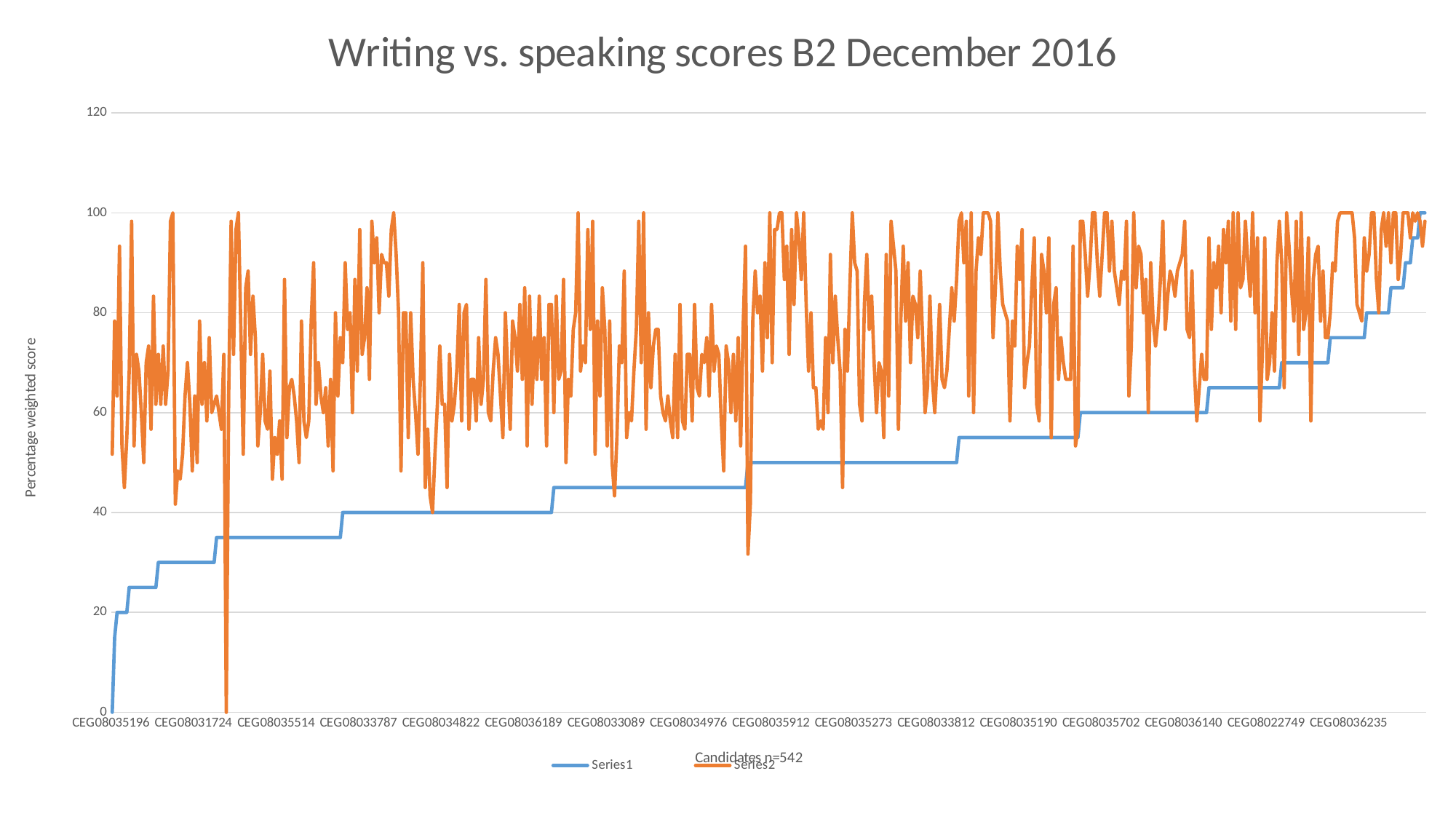
Does Series1 rise or fall as you move from left to right along the x axis? Rise What is the lowest value Series1 reaches? 0 What is the label on the vertical axis? Percentage weighted score What is the title of the chart? Writing vs. speaking scores B2 December 2016 What type of chart is shown on the slide? Line chart What is the highest value Series1 reaches? 100 How many candidates are plotted according to the note under the x axis? 542 How many series does the legend list? 2 Is the value of Series1 at CEG08035912 greater or less than 60? less Which series is generally higher across most of the chart, Series1 or Series2? Series2 Is the value of Series1 at CEG08036235 greater or less than 60? greater Is the value of Series1 at CEG08034822 greater or less than 60? less